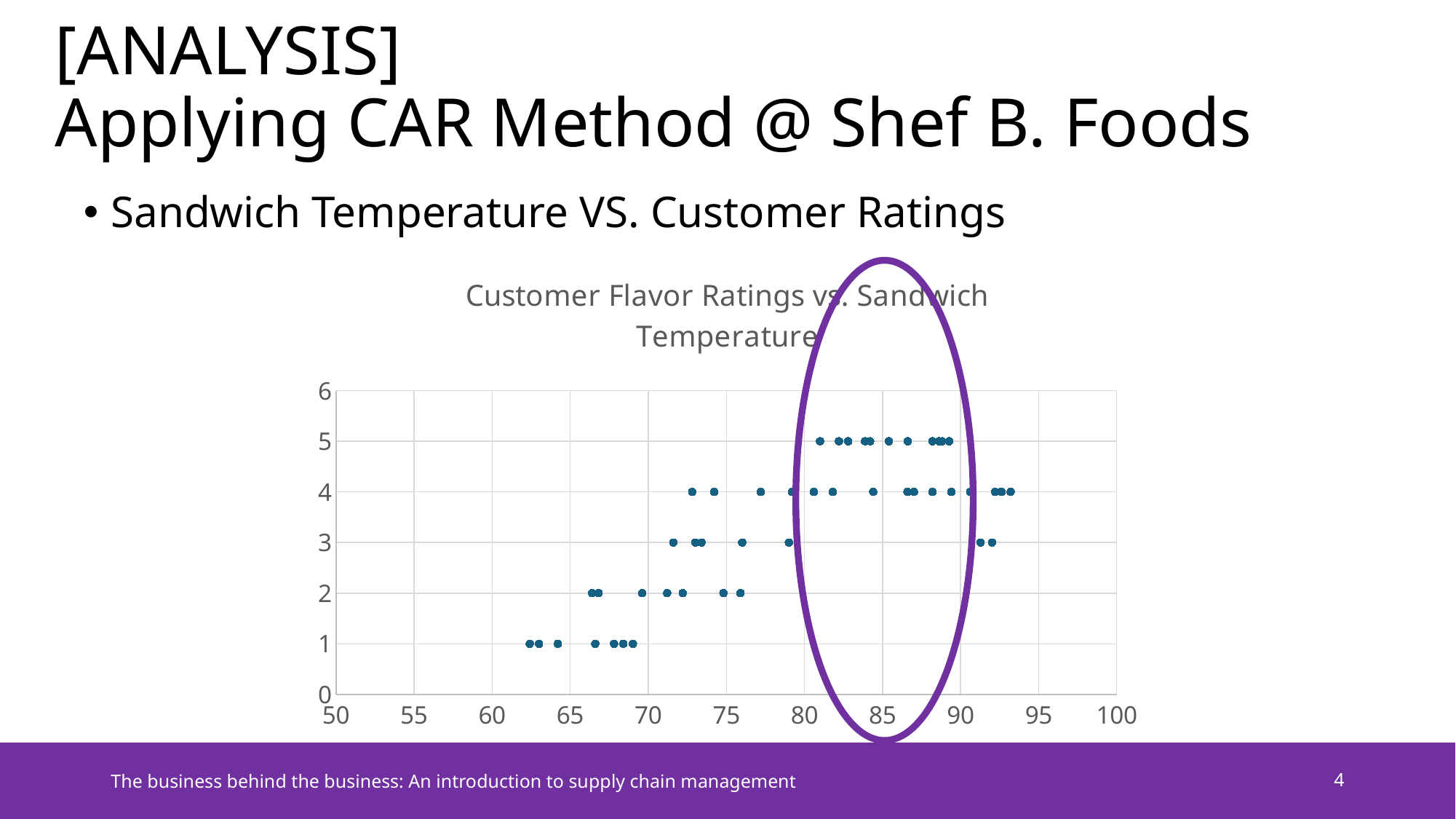
What is the lowest customer flavor rating plotted on the chart? 1 What is the lowest value shown on the x axis of the chart? 50 What is the title of the chart? Customer Flavor Ratings vs. Sandwich Temperature Is the rating of the points at a temperature of about 63 greater or less than 2? less What kind of chart is shown on the slide? Scatter chart Are the sandwich temperatures of the points rated 5 greater or less than 80? greater What is the highest value shown on the y axis of the chart? 6 Is the rating of the points at a temperature of about 92 greater or less than 2? greater Do customer flavor ratings generally rise or fall as sandwich temperature increases along the x axis? Rise What is the highest customer flavor rating plotted on the chart? 5